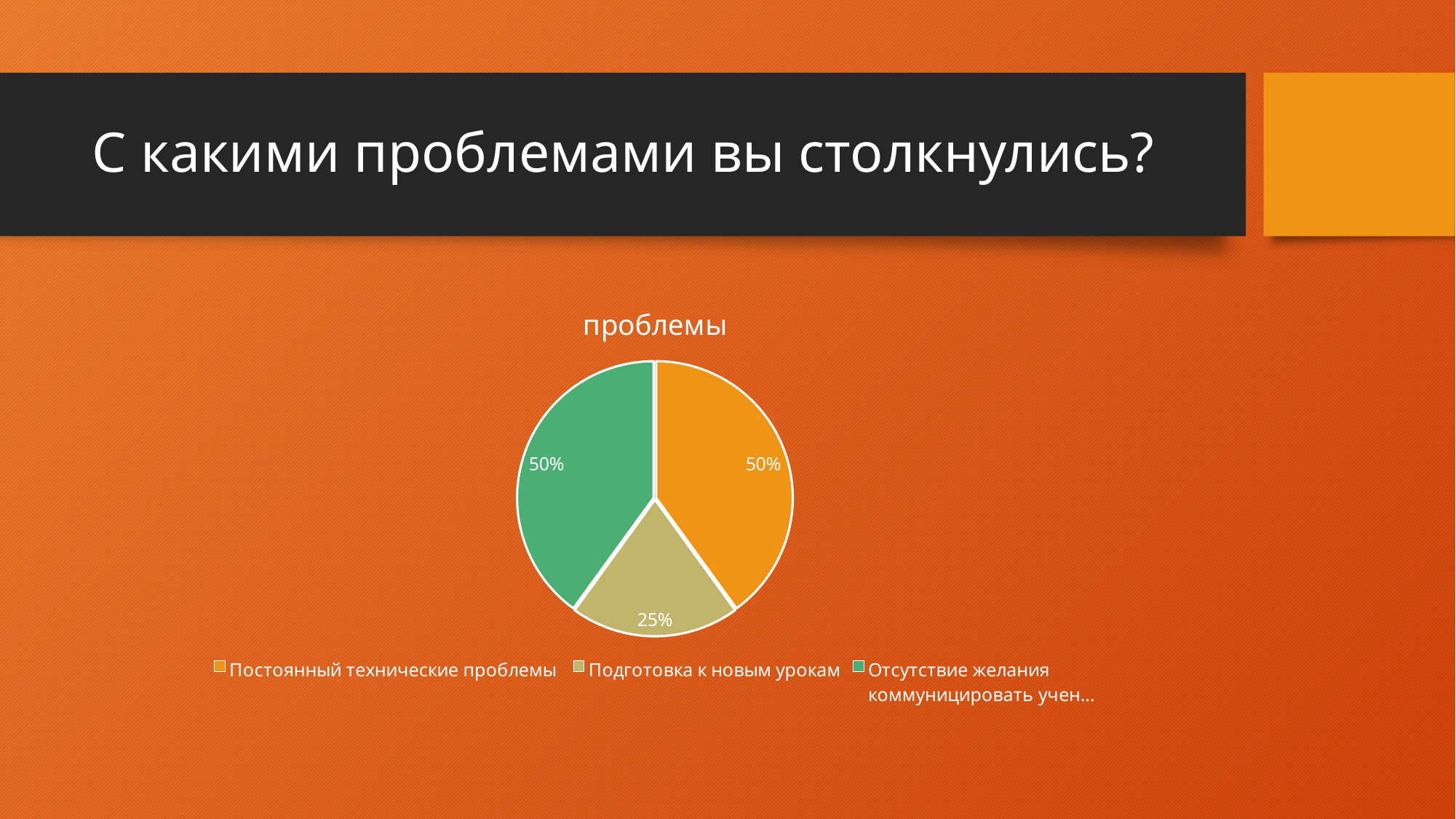
Which category has the smallest slice in the pie chart? Подготовка к новым урокам How many entries does the legend list? 3 What percentage is shown for "Подготовка к новым урокам"? 25% What percentage is shown for the green slice, "Отсутствие желания коммуницировать учен…"? 50% Which is larger: "Постоянный технические проблемы" or "Подготовка к новым урокам"? Постоянный технические проблемы What percentage is shown for "Постоянный технические проблемы"? 50% How many slices does the pie chart have? 3 What is the title of the chart? проблемы What is the difference between the percentages for "Постоянный технические проблемы" and "Подготовка к новым урокам"? 25% What colour is the slice for "Подготовка к новым урокам"? tan (beige) What type of chart is shown on the slide? pie chart